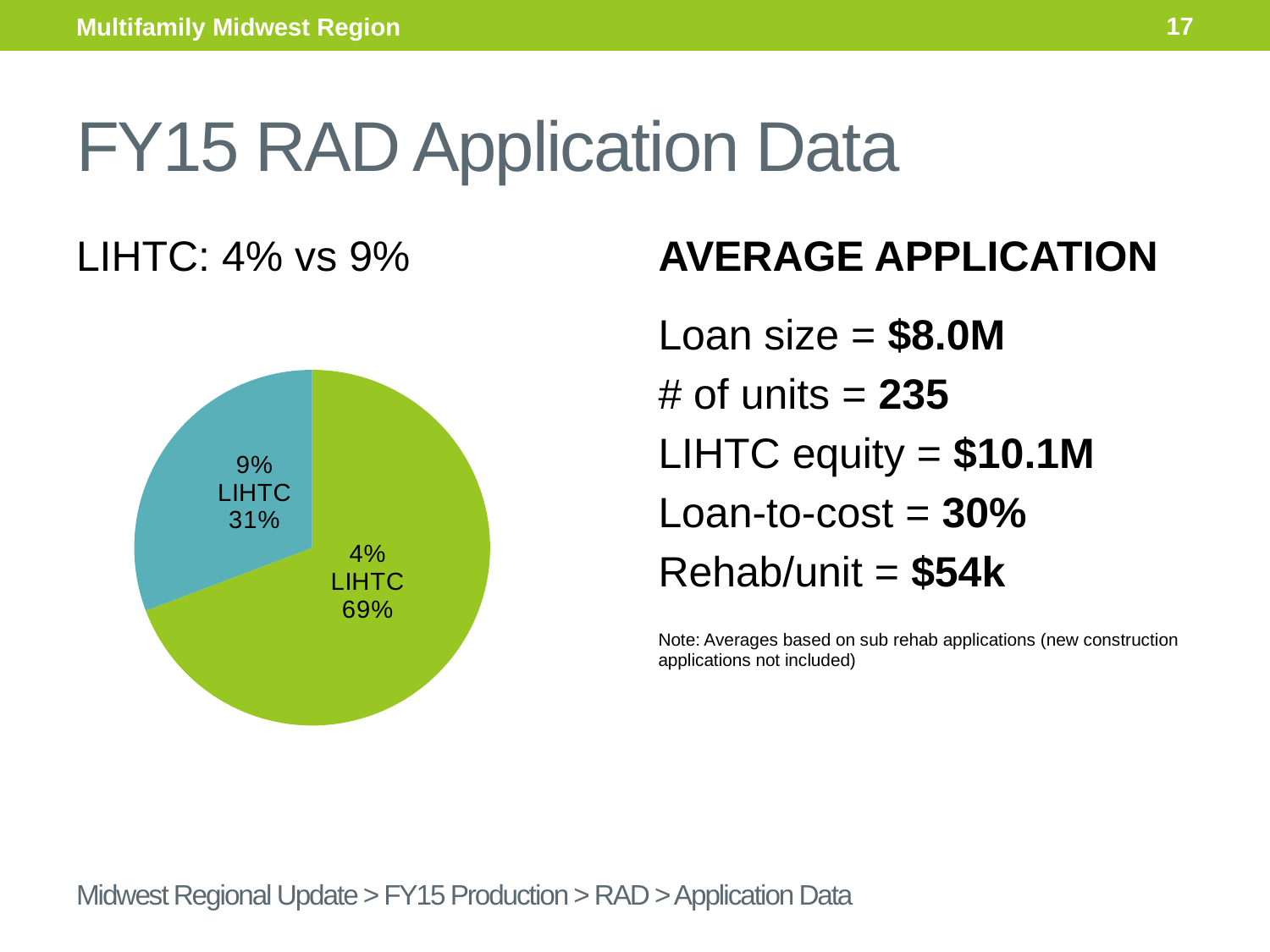
Which slice of the pie chart is the smallest? 9% LIHTC What colour is the 9% LIHTC slice of the pie chart? Blue What is the heading above the pie chart? LIHTC: 4% vs 9% What kind of chart is shown on the slide? Pie chart Is the share of the 4% LIHTC slice greater or less than 50%? greater What share of the pie does the 9% LIHTC slice represent? 31% Which slice of the pie chart is the largest? 4% LIHTC What share of the pie does the 4% LIHTC slice represent? 69% Which is larger, the 4% LIHTC slice or the 9% LIHTC slice? 4% LIHTC What is the difference in percentage points between the 4% LIHTC slice and the 9% LIHTC slice? 38 How many slices does the pie chart have? 2